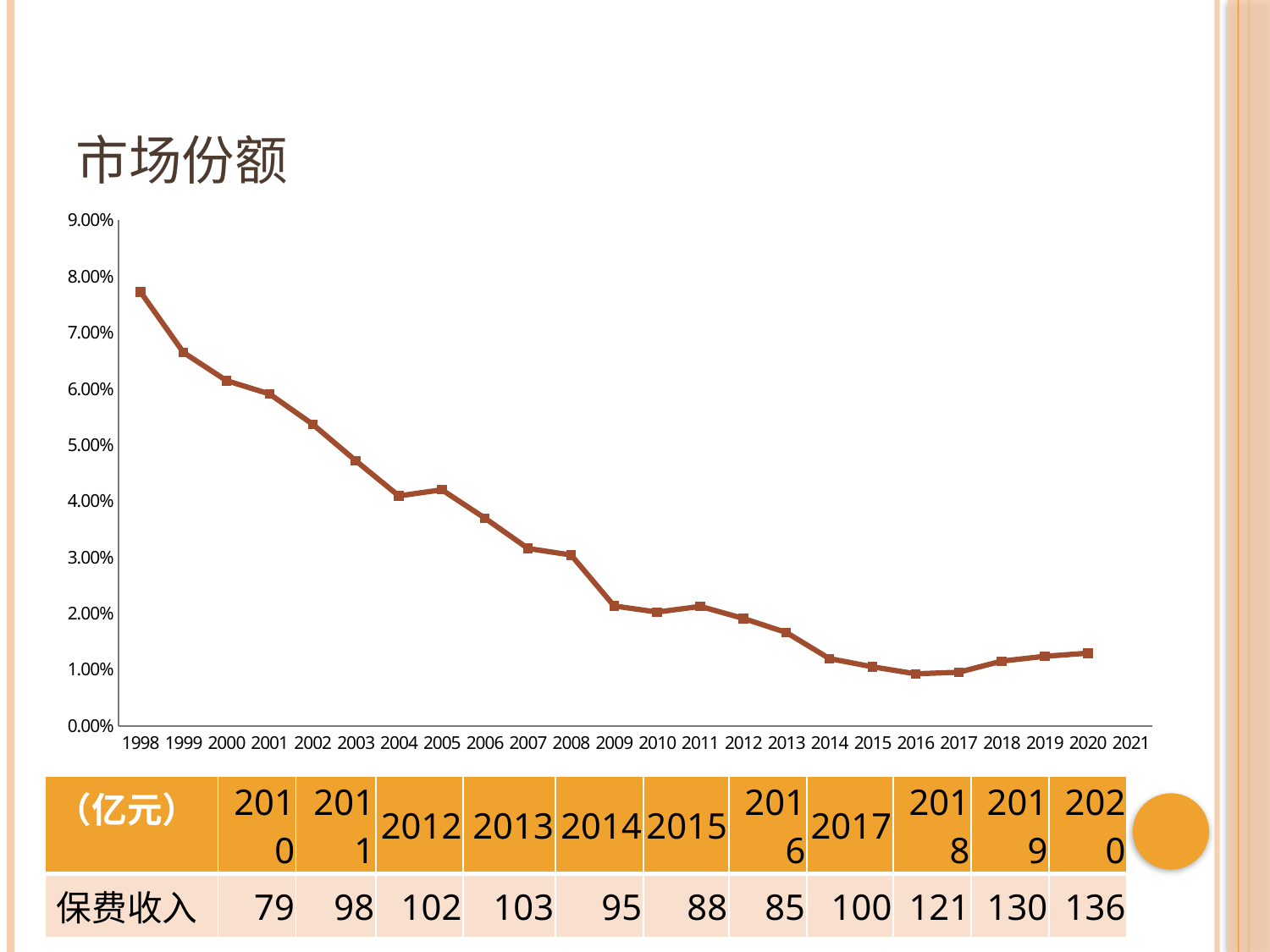
Which year has the highest market share value on the chart? 1998 Is the value for 1998 greater or less than 7.00%? greater Is the value for 2013 greater or less than 2.00%? less Is the value for 2003 greater or less than 5.00%? less Do the values generally rise or fall from 1998 to 2016? fall What is the highest value shown on the vertical axis? 9.00% What kind of chart is shown on the slide? line chart Which is larger, the value for 2000 or the value for 2010? 2000 Which is larger, the value for 1998 or the value for 2020? 1998 What is the title of the chart? 市场份额